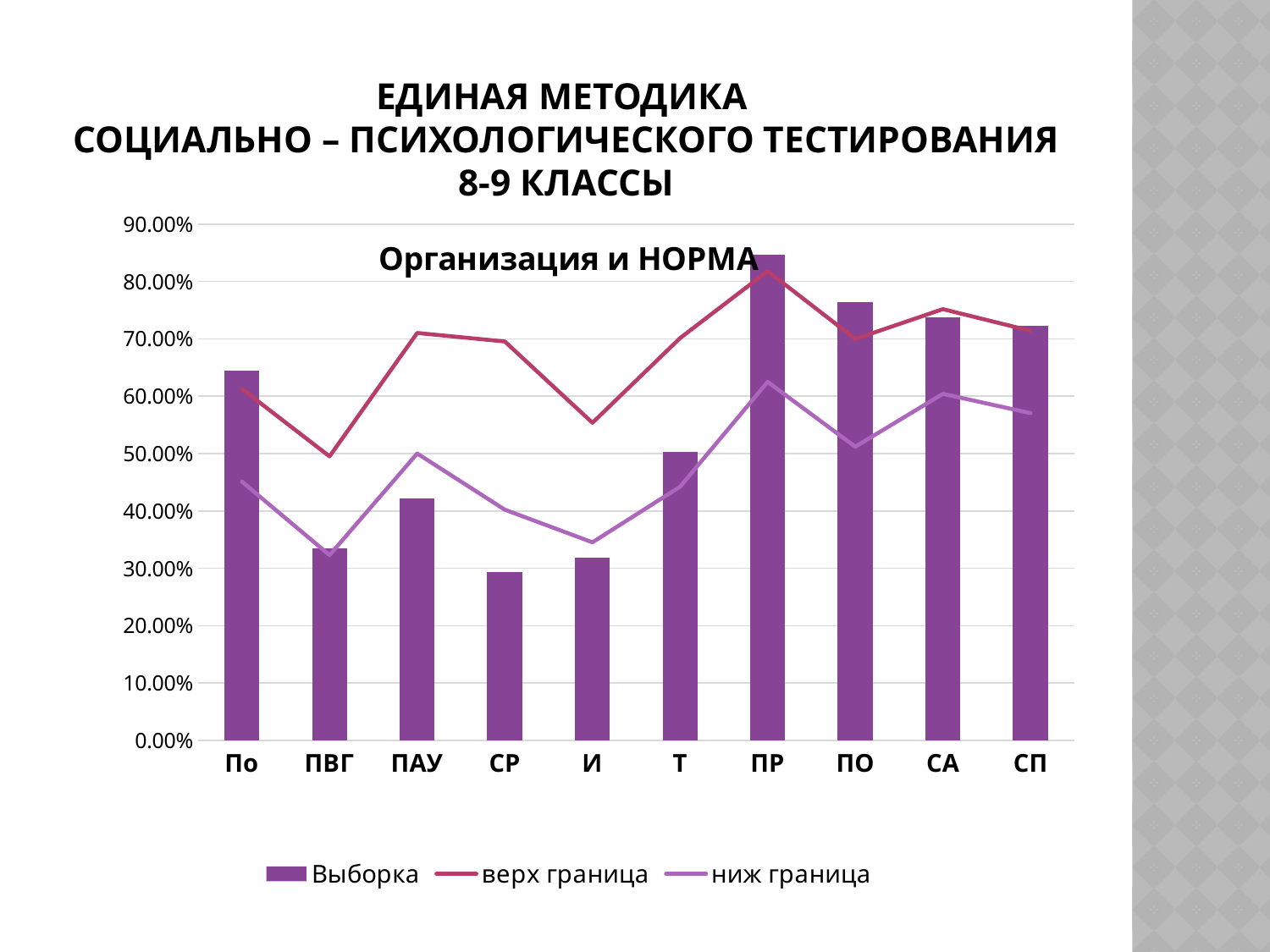
Is the Выборка value for ПАУ greater or less than 50.00%? less Which category has the lowest Выборка bar? СР Which has the larger Выборка value, По or ПВГ? По Is the Выборка value for ПР greater or less than 80.00%? greater Is the Выборка value for ПО greater or less than 70.00%? greater What kind of chart is this? bar chart with two line series How many series does the legend list? 3 How many categories are shown on the x axis? 10 Which category has the highest Выборка bar? ПР What is the title of the chart? Организация и НОРМА Which series is drawn as bars in the chart? Выборка